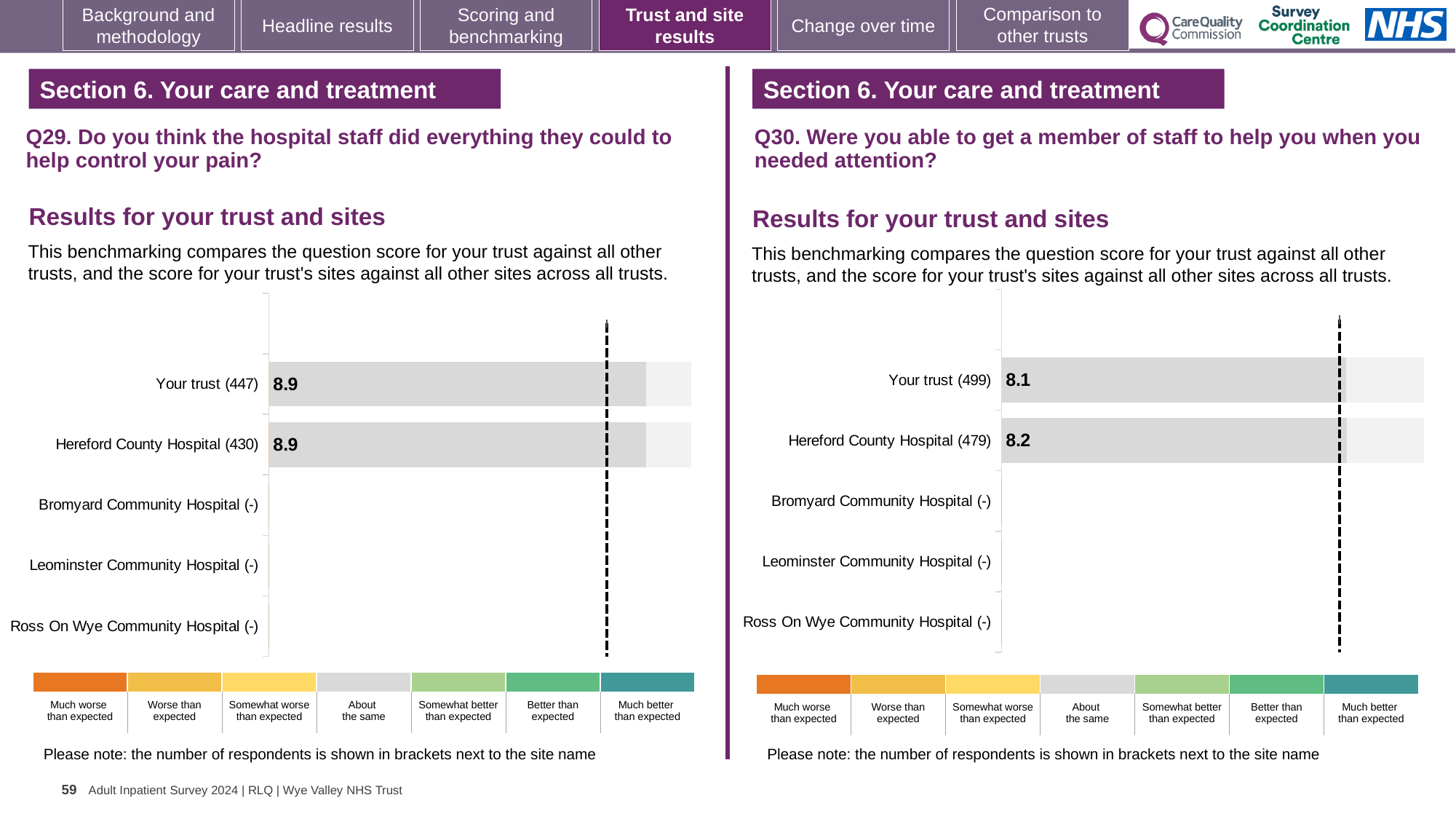
In the Q30 chart on the right, which has the higher score, Your trust or Hereford County Hospital? Hereford County Hospital In the Q29 chart on the left, what is the score for Your trust? 8.9 In the Q30 chart on the right, what is the score for Your trust? 8.1 In the Q29 chart on the left, how many sites show no score (marked with a dash)? 3 How many site/trust categories are listed on the y axis of the Q29 chart on the left? 5 How many benchmark categories are shown in the colour key below the Q30 chart on the right? 7 In the Q30 chart on the right, what is the difference between the Hereford County Hospital score and the Your trust score? 0.1 In the Q29 chart on the left, how many respondents are shown in brackets for Your trust? 447 What kind of chart is the Q30 chart on the right? Bar chart In the Q29 chart on the left, what is the score for Hereford County Hospital? 8.9 In the Q30 chart on the right, how many respondents are shown in brackets for Hereford County Hospital? 479 In the Q30 chart on the right, what is the score for Hereford County Hospital? 8.2